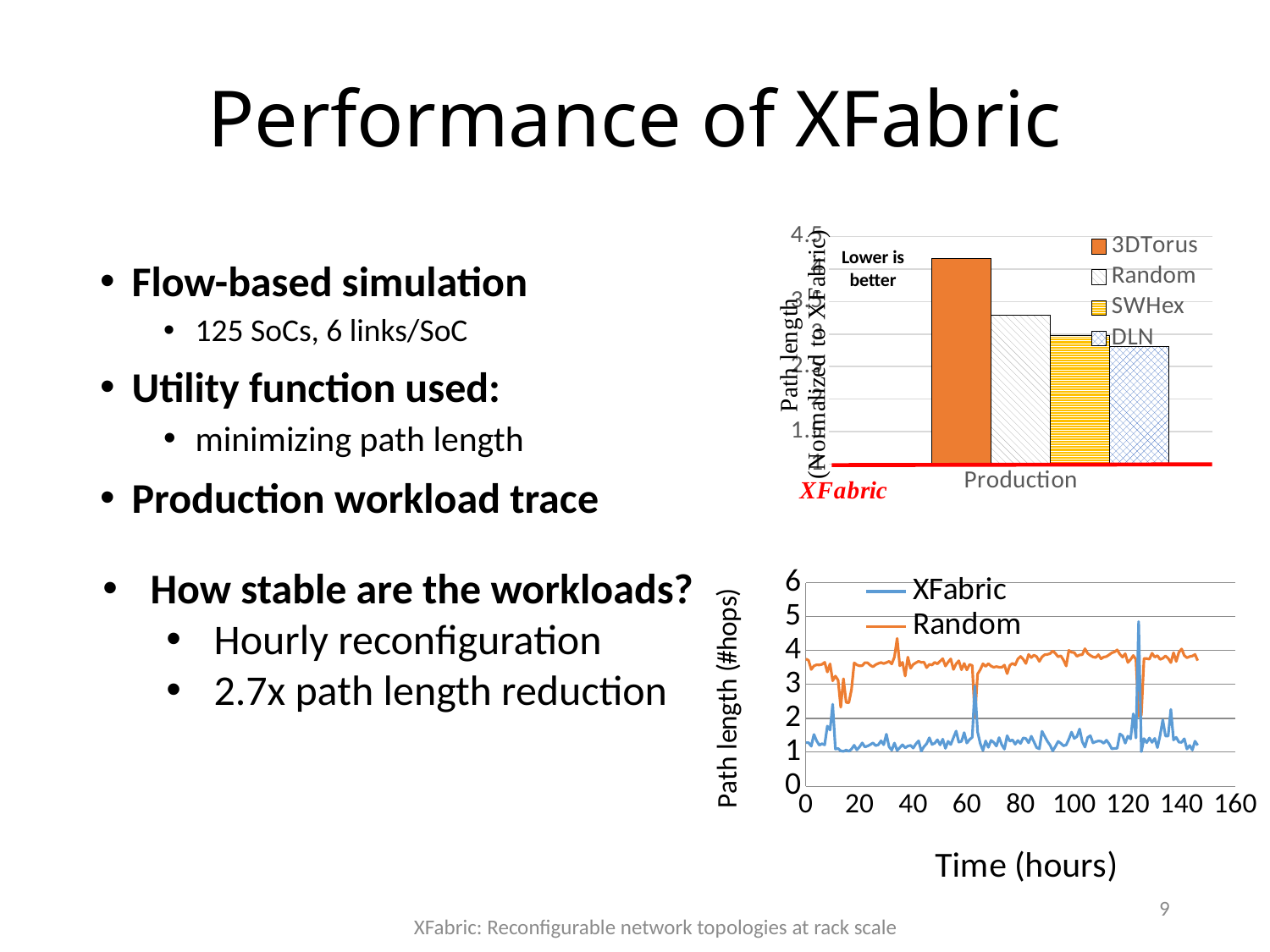
In the bottom-right line chart, how many series does the legend list? 2 In the top-right bar chart, is the value for Random greater or less than 3.5? less In the top-right bar chart, how many categories are shown on the x axis? 1 In the bottom-right line chart, what is the label of the x axis? Time (hours) In the top-right bar chart, which series has the lowest bar for Production? DLN In the top-right bar chart, which is larger, the bar for 3DTorus or the bar for Random? 3DTorus In the bottom-right line chart, which series generally has the higher path length, XFabric or Random? Random In the top-right bar chart, is the value for 3DTorus greater or less than 3.5? greater What kind of chart is the bottom-right chart on the slide? line chart What kind of chart is the top-right chart on the slide? bar chart In the top-right bar chart, which series has the highest bar for Production? 3DTorus In the top-right bar chart, how many series does the legend list? 4